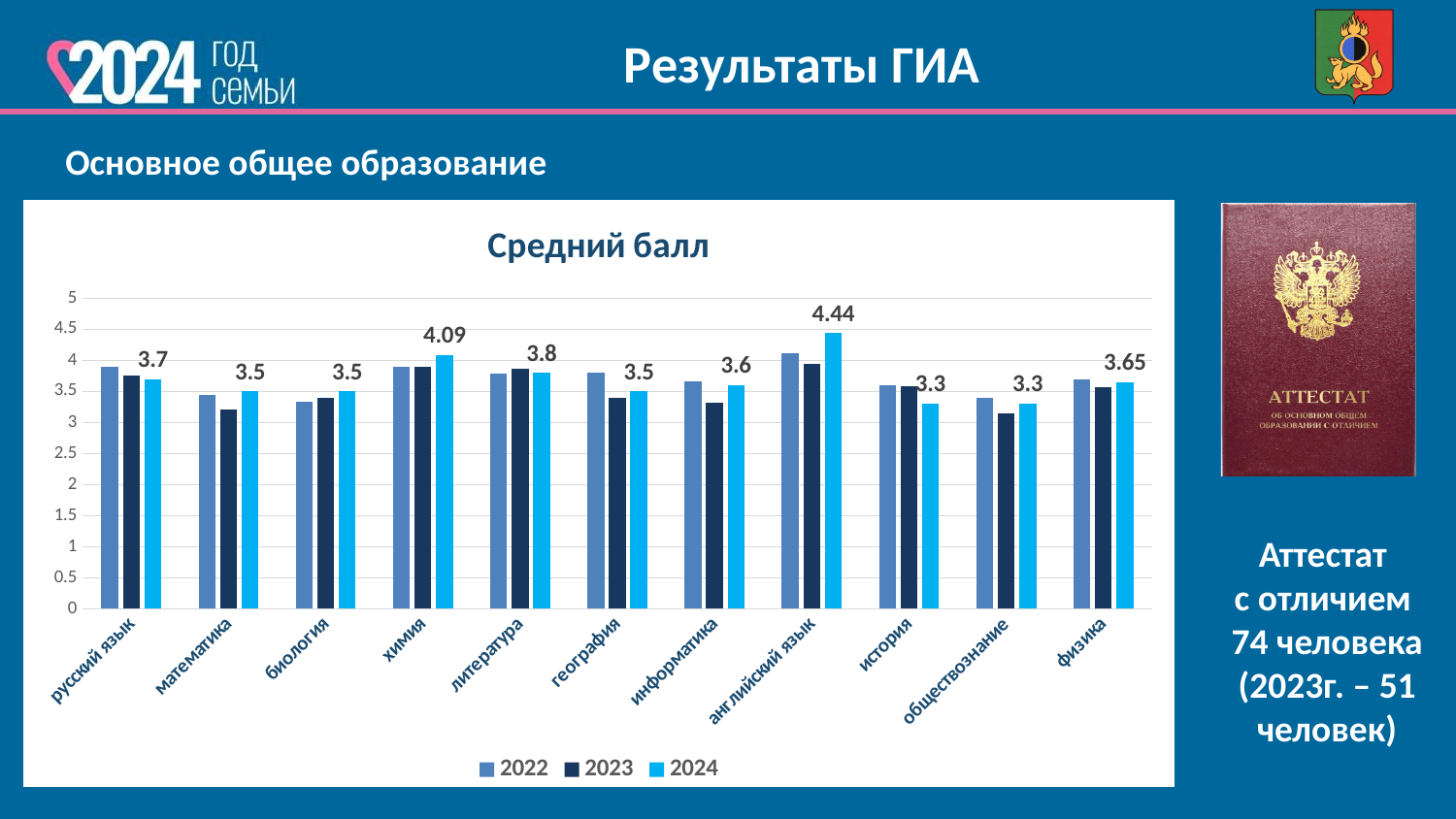
Is the 2023 value for математика greater or less than 3.5? less How many subject categories are shown on the x axis? 11 Which subject has the highest 2024 value? английский язык What is the title of the chart? Средний балл What is the 2024 value for физика? 3.65 What kind of chart is shown on the slide? bar chart What is the 2024 value for химия? 4.09 Which years are listed in the legend? 2022, 2023, 2024 What is the 2024 value for английский язык? 4.44 How many series does the legend list? 3 What is the difference between the 2024 values for английский язык and химия? 0.35 Which is larger, the 2024 value for литература or the 2024 value for история? литература